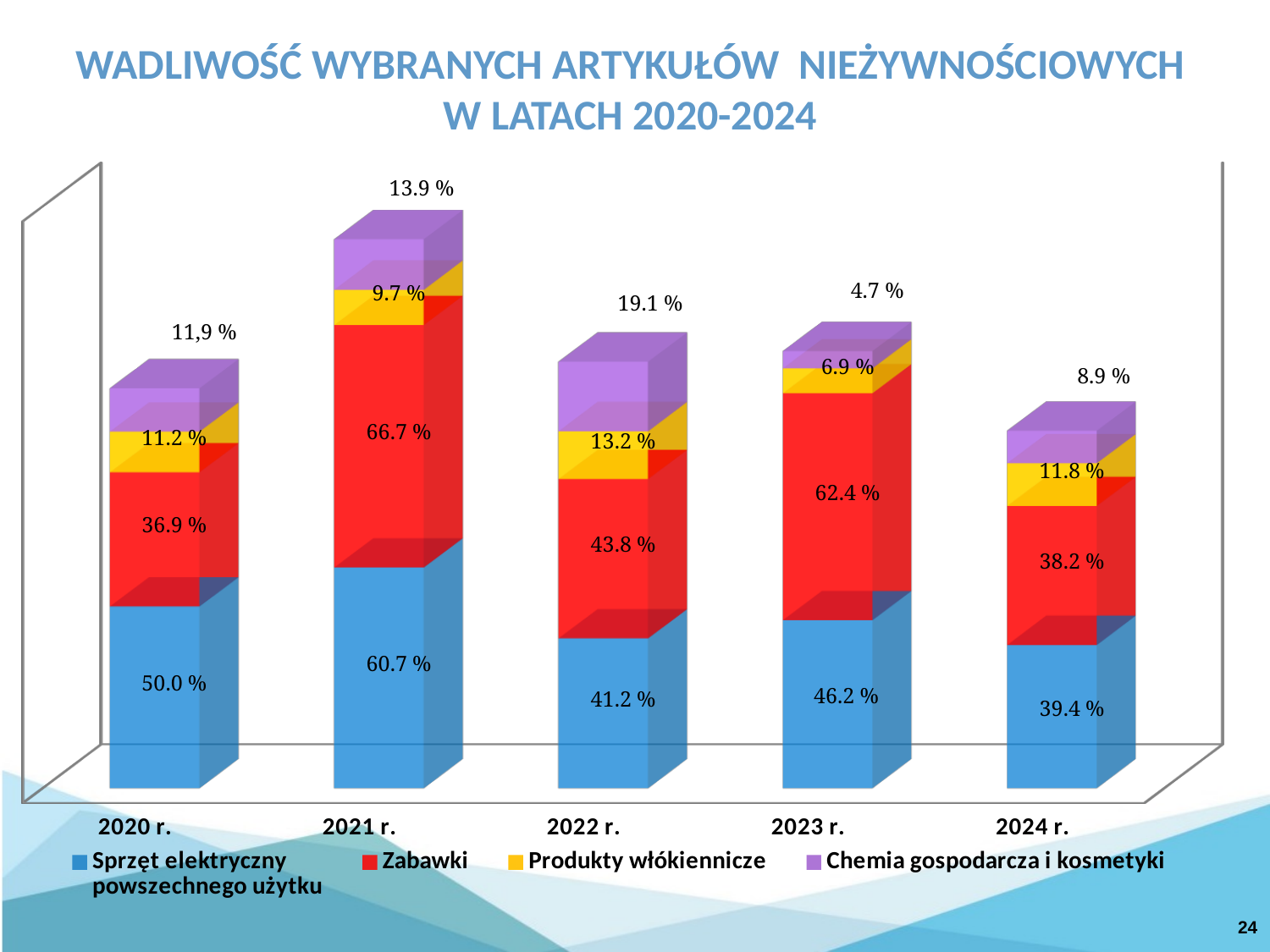
What is the value for Produkty włókiennicze in 2023 r.? 6.9 % What is the difference between the Zabawki values in 2021 r. and 2022 r.? 22.9 % What is the value for Chemia gospodarcza i kosmetyki in 2022 r.? 19.1 % How many series does the legend list? 4 How many years (categories) are shown on the x axis? 5 In which year is the value for Chemia gospodarcza i kosmetyki the lowest? 2023 r. What is the value for Sprzęt elektryczny powszechnego użytku in 2024 r.? 39.4 % In which year is the value for Sprzęt elektryczny powszechnego użytku the highest? 2021 r. What type of chart is shown on the slide? Stacked bar chart Which is larger in 2024 r.: the value for Sprzęt elektryczny powszechnego użytku or the value for Zabawki? Sprzęt elektryczny powszechnego użytku What is the value for Zabawki in 2021 r.? 66.7 % Which colour represents Zabawki in the chart? Red